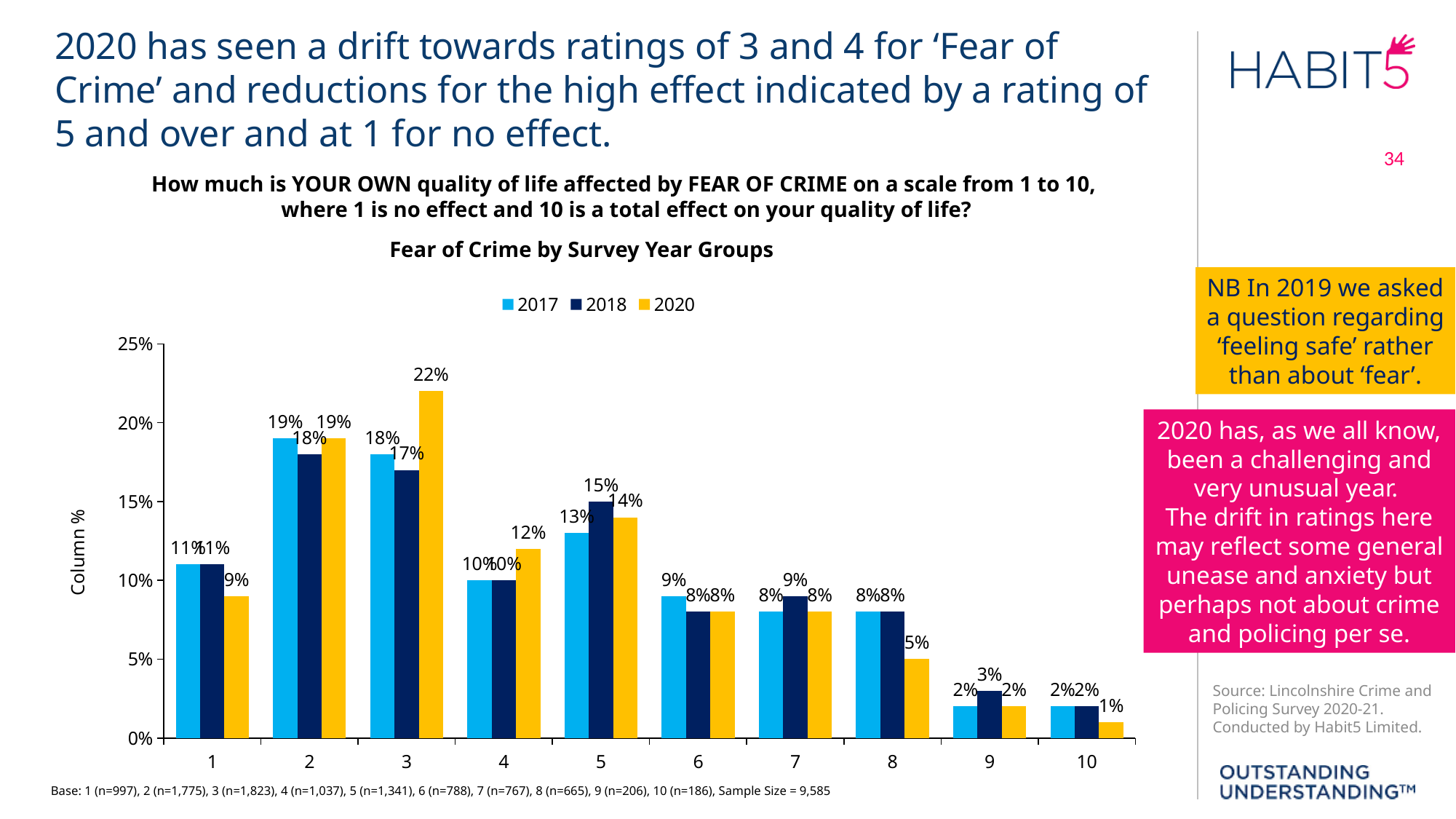
Which rating has the lowest 2020 value? 10 What is the 2020 value for rating 8? 5% Which rating has the highest 2020 value? 3 What is the title of the chart? Fear of Crime by Survey Year Groups For rating 1, which is larger: the 2017 value or the 2020 value? 2017 How many rating categories are shown on the x axis? 10 What is the 2017 value for rating 1? 11% What is the difference between the 2020 and 2018 values for rating 3? 5% What kind of chart is shown? Bar chart How many series does the legend list? 3 What is the 2018 value for rating 5? 15% What is the 2020 value for rating 3? 22%